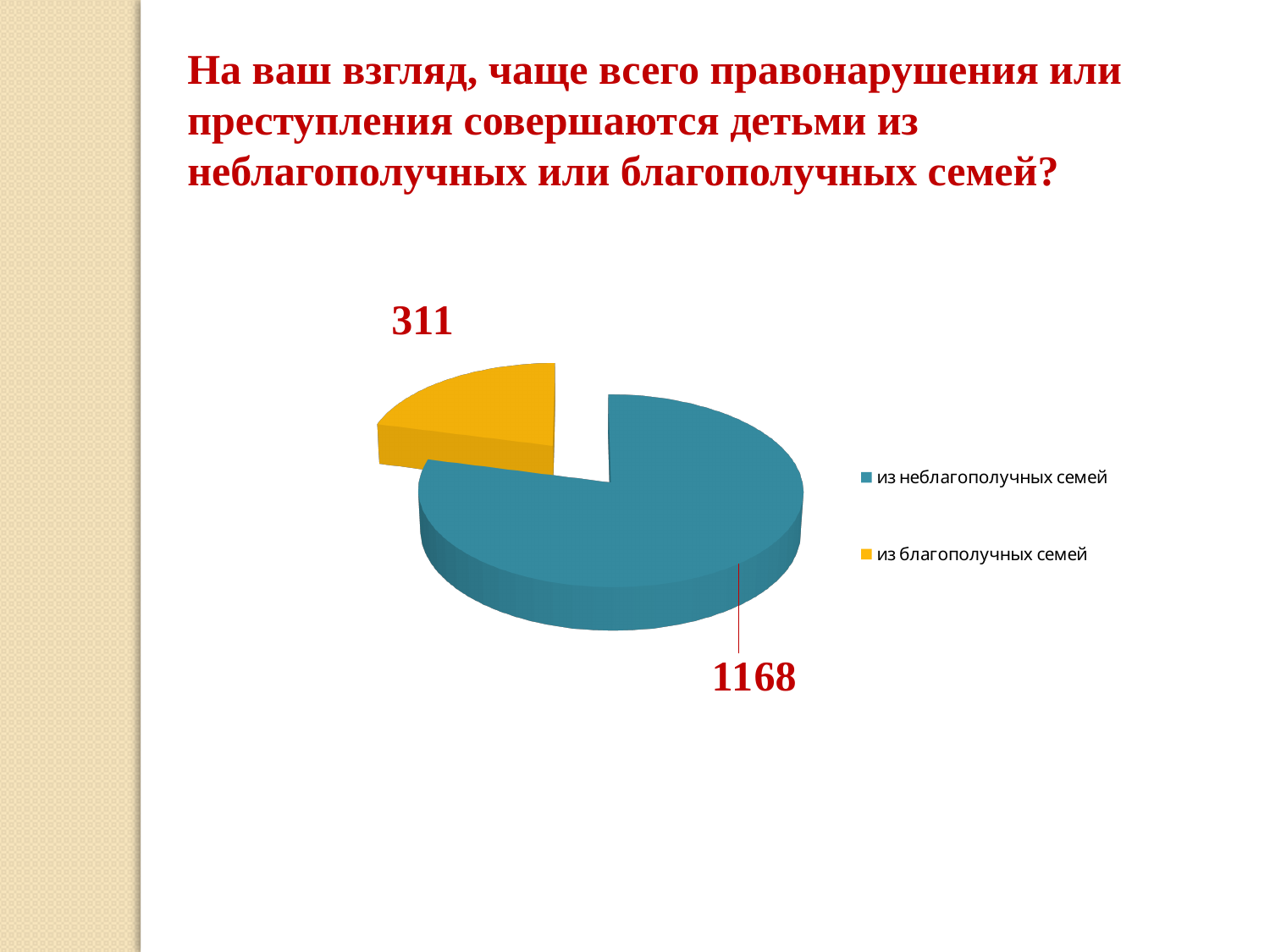
What is the total of the two values shown on the pie chart? 1479 How many slices does the pie chart have? 2 How many entries does the legend list? 2 What value is shown for the slice "из благополучных семей"? 311 What is the difference between the values for "из неблагополучных семей" and "из благополучных семей"? 857 What colour is the slice for "из благополучных семей"? Yellow What value is shown for the slice "из неблагополучных семей"? 1168 Which category has the largest slice of the pie? из неблагополучных семей Which category has the smallest slice of the pie? из благополучных семей Which is larger: the value for "из благополучных семей" or the value for "из неблагополучных семей"? из неблагополучных семей What kind of chart is shown on the slide? Pie chart What colour is the slice for "из неблагополучных семей"? Blue